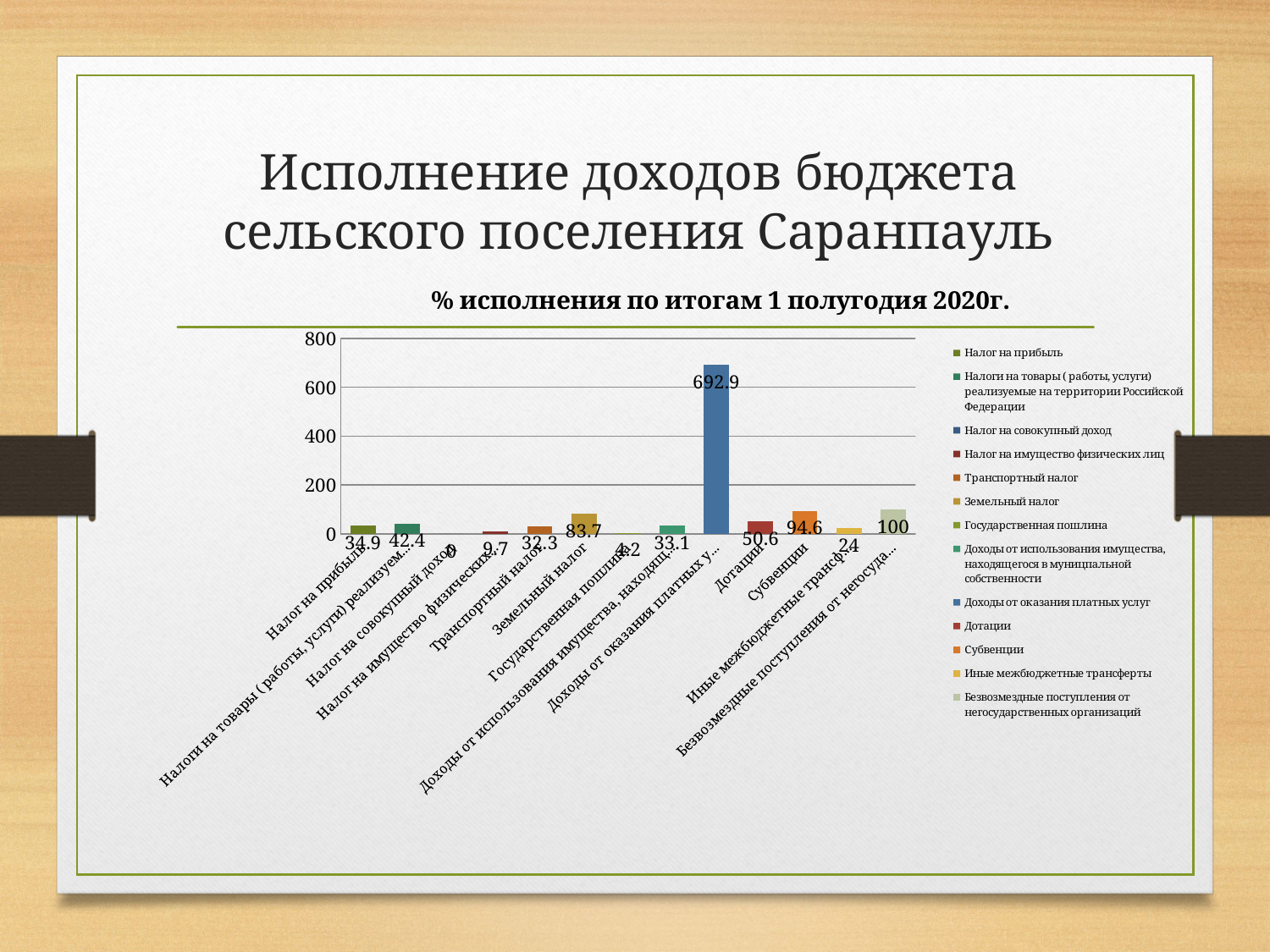
What is the difference between the values for Субвенции and Дотации? 44 Which category has the highest value? Доходы от оказания платных услуг How many categories are plotted on the chart? 13 What is the value for Доходы от оказания платных услуг? 692.9 What kind of chart is shown on the slide? bar chart Which is larger, the value for Налог на прибыль or the value for Транспортный налог? Налог на прибыль What is the value for Налог на имущество физических лиц? 9.7 What is the value for Субвенции? 94.6 Which category has the lowest value? Налог на совокупный доход What is the value for Земельный налог? 83.7 Is the value for Доходы от оказания платных услуг greater or less than 600? greater What is the title of the chart? % исполнения по итогам 1 полугодия 2020г.